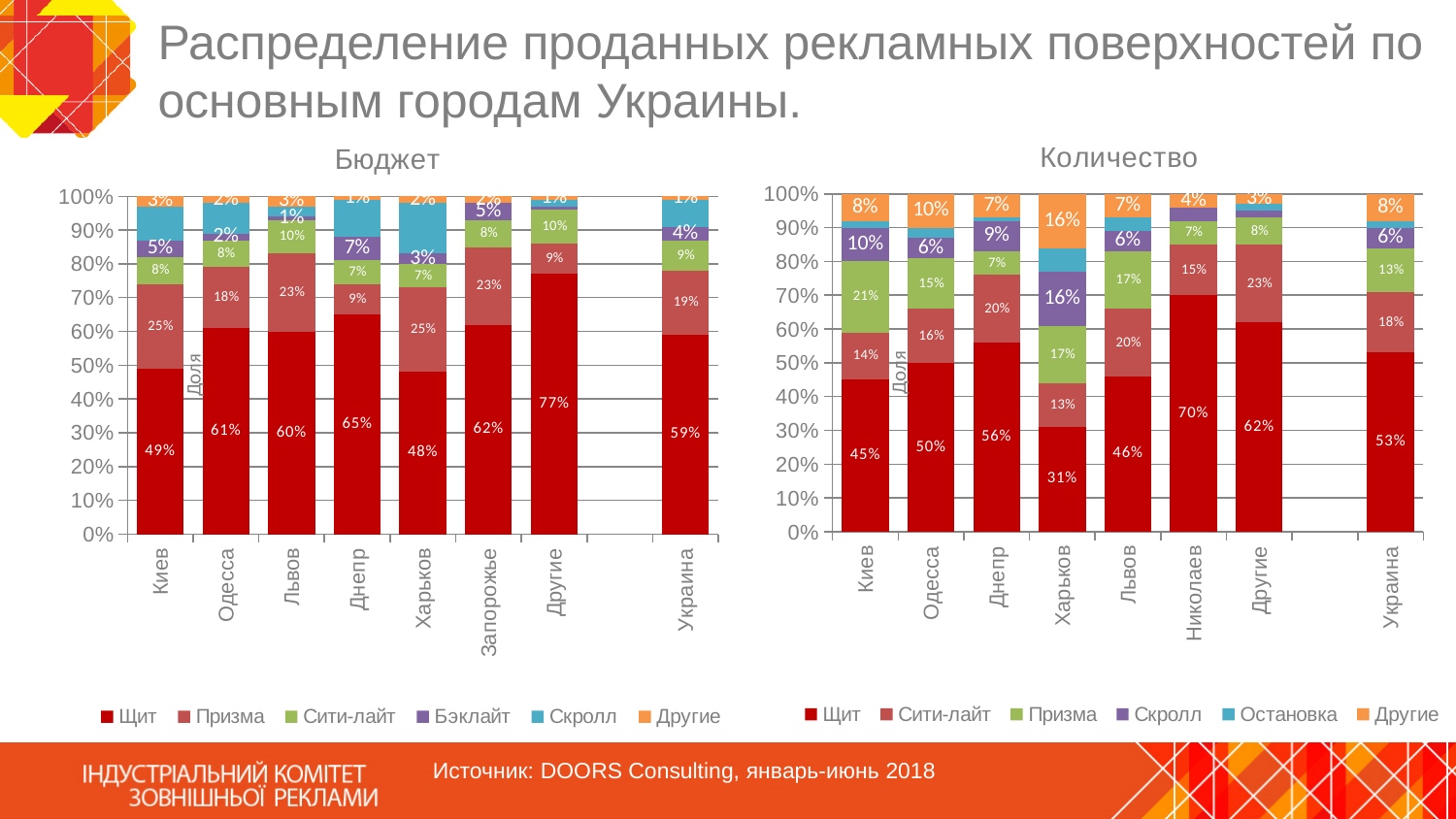
In the 'Количество' chart, which is larger: the Щит share for Николаев or for Одесса? Николаев How many series does the legend of the 'Количество' chart list? 6 In the 'Количество' chart, what is the share of Сити-лайт for Другие? 23% In the 'Бюджет' chart, what is the share of Щит for Киев? 49% In the 'Количество' chart, what is the share of Призма for Украина? 13% In the 'Бюджет' chart, what is the share of Призма for Львов? 23% How many categories are shown on the x axis of the 'Бюджет' chart? 8 In the 'Бюджет' chart, which city has the highest share of Щит? Другие In the 'Количество' chart, which city has the lowest share of Щит? Харьков In the 'Количество' chart, what is the share of Щит for Харьков? 31% In the 'Бюджет' chart, how many percentage points higher is the Щит share for Другие than for Киев? 28 What kind of chart is the 'Бюджет' chart? stacked bar chart